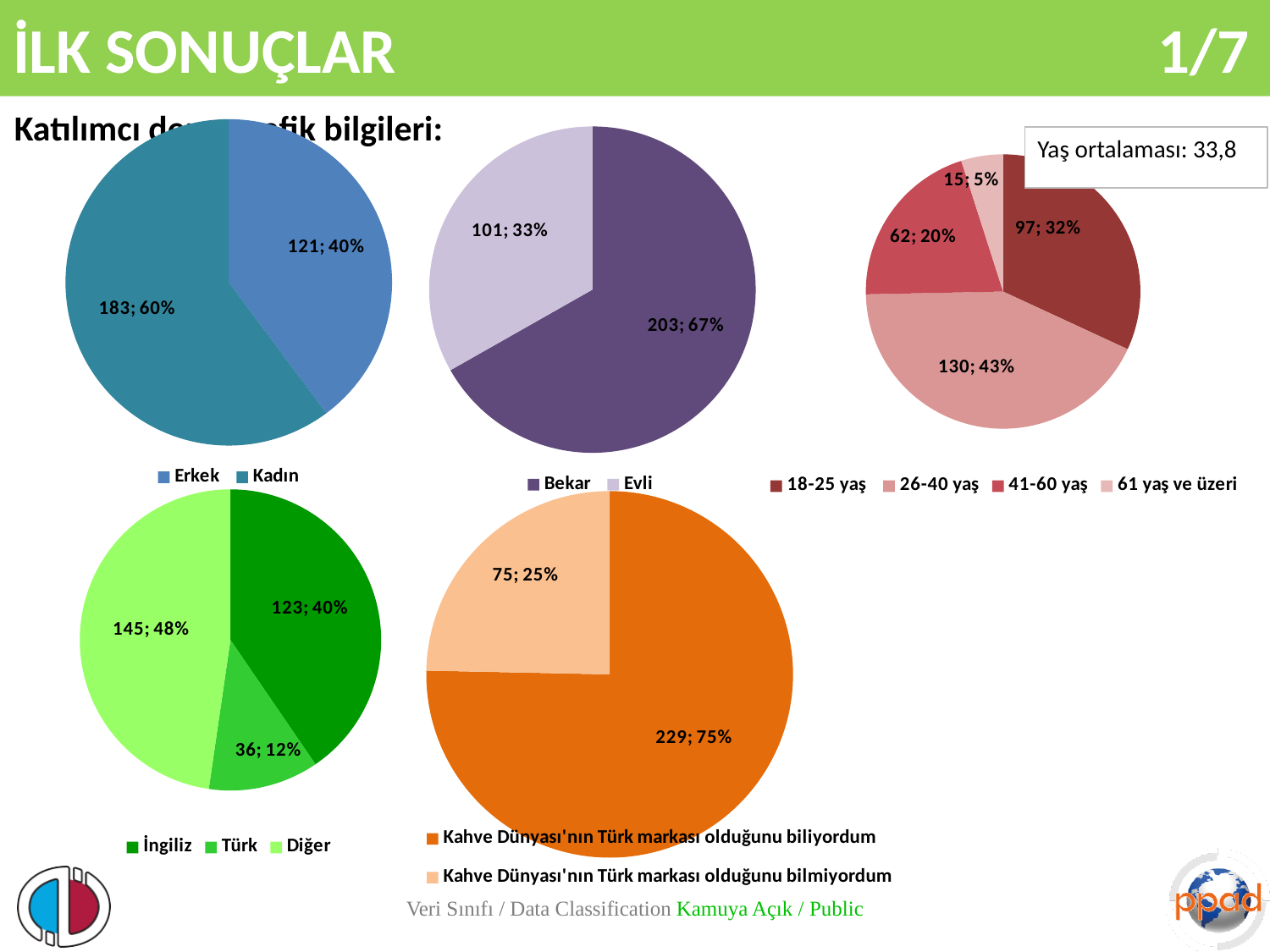
How many categories does the legend of the top-right pie chart (age groups) list? 4 What type of chart is used for all the charts on this slide? Pie chart In the top-left pie chart (legend Erkek / Kadın), what share of the pie does Erkek have? 40% In the bottom-left pie chart (legend İngiliz / Türk / Diğer), what is the value shown for Türk? 36; 12% In the top-middle pie chart (legend Bekar / Evli), what is the difference between the counts for Bekar and Evli? 102 In the bottom-left pie chart (legend İngiliz / Türk / Diğer), which category has the largest slice? Diğer In the top-middle pie chart (legend Bekar / Evli), what is the value shown for Bekar? 203; 67% In the top-right pie chart (age groups), which age group has the smallest slice? 61 yaş ve üzeri In the top-left pie chart (legend Erkek / Kadın), what is the value shown for Kadın? 183; 60% In the top-right pie chart (age groups), which age group has the largest slice? 26-40 yaş In the bottom-middle pie chart, what is the value shown for 'Kahve Dünyası'nın Türk markası olduğunu biliyordum'? 229; 75% In the top-right pie chart (age groups), what is the value shown for 41-60 yaş? 62; 20%